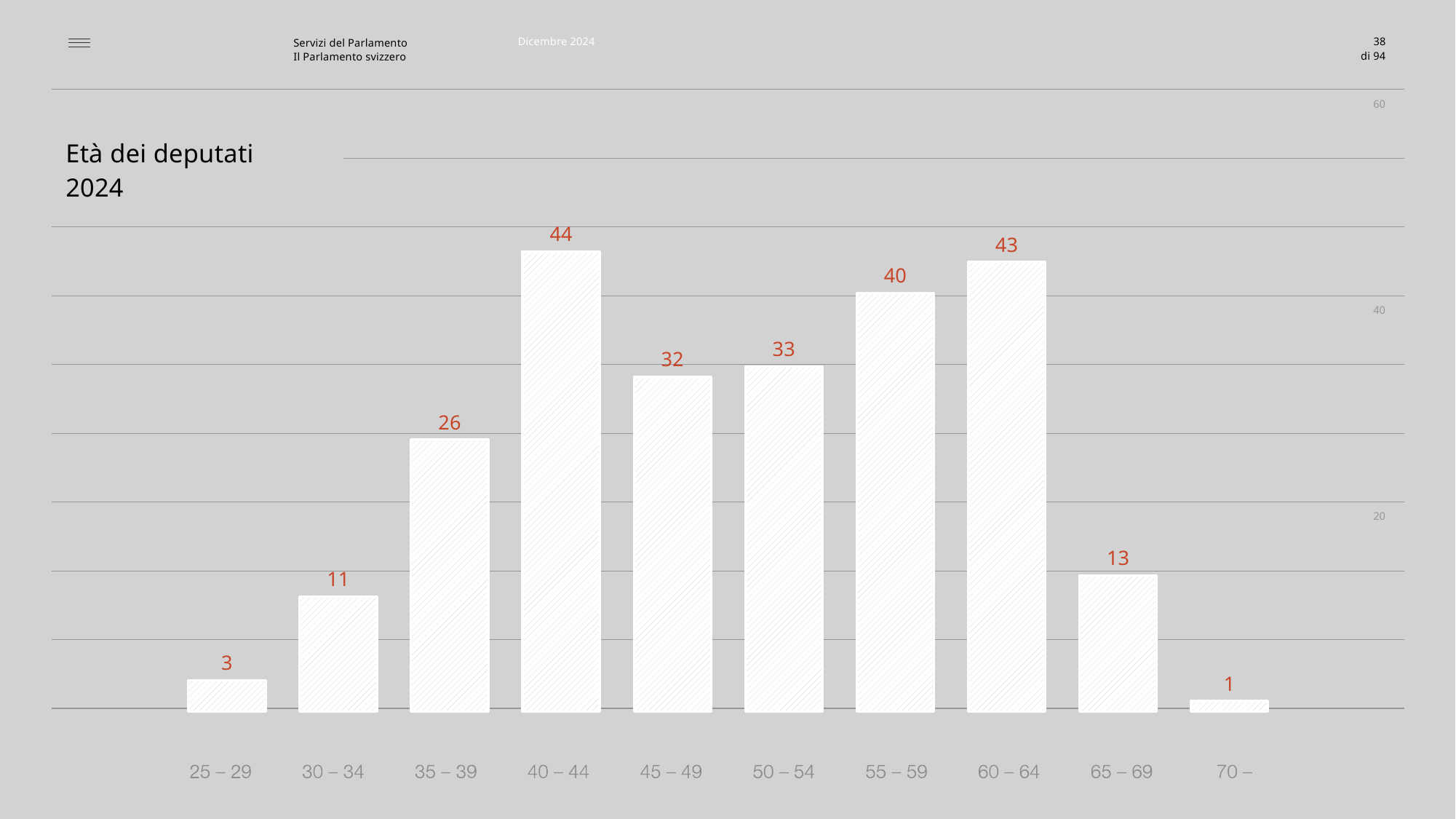
What is the title of the chart? Età dei deputati 2024 How many age groups are shown on the x axis? 10 Is the value for 50 – 54 greater or less than 40? less Do the values rise or fall from 25 – 29 to 40 – 44? rise What is the difference between the values for 60 – 64 and 55 – 59? 3 What kind of chart is shown on the slide? bar chart Which age group has the highest value? 40 – 44 Which is larger, the value for 35 – 39 or the value for 45 – 49? 45 – 49 What is the value for the 65 – 69 age group? 13 What is the value for the 25 – 29 age group? 3 What is the value for the 40 – 44 age group? 44 Which age group has the lowest value? 70 –